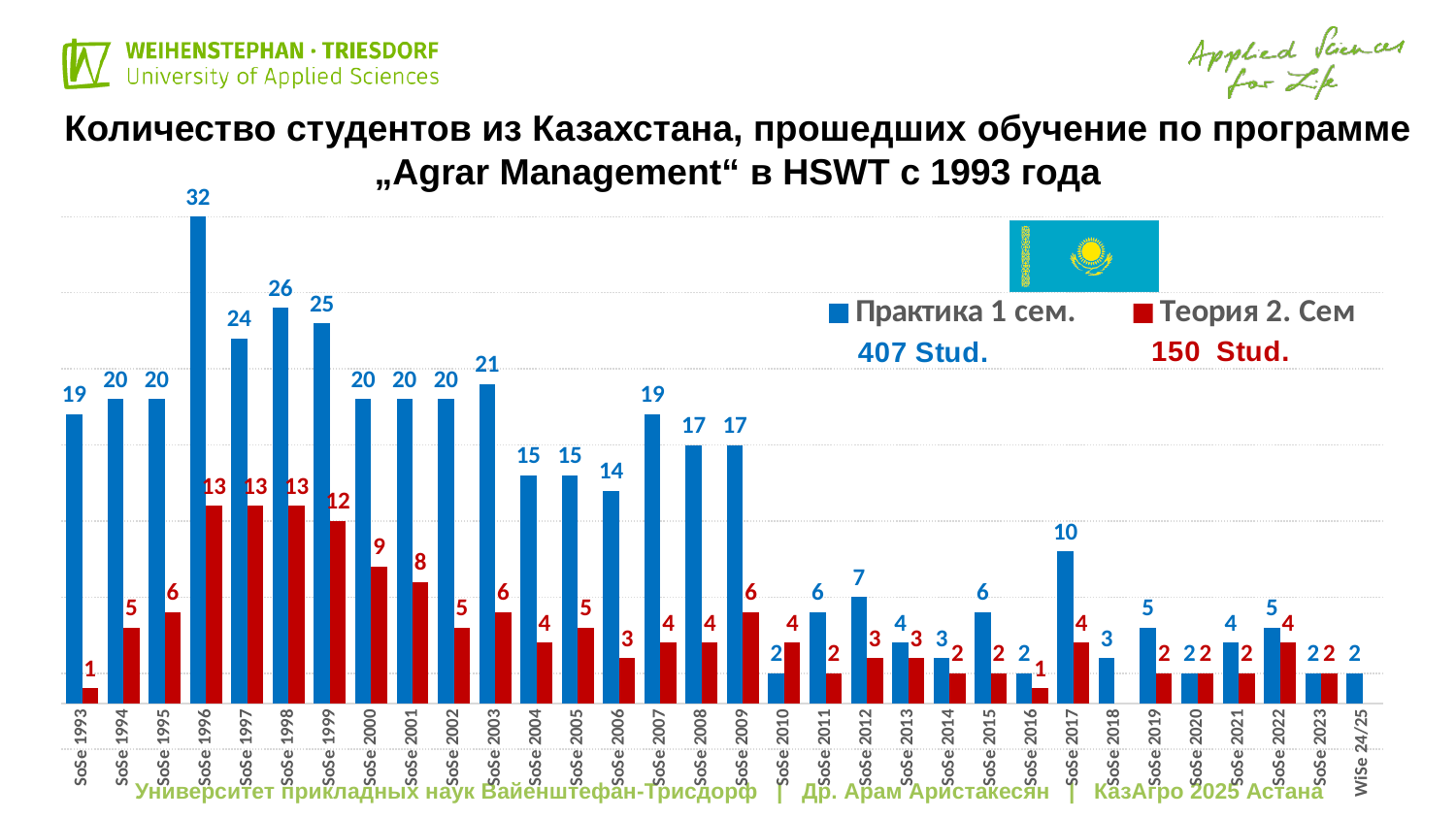
Which year has the highest value for Практика 1 сем.? SoSe 1996 What total number of students is shown next to the legend entry Теория 2. Сем? 150 Stud. What is the value of Теория 2. Сем for SoSe 2000? 9 Which is larger for SoSe 2003: Практика 1 сем. or Теория 2. Сем? Практика 1 сем. What type of chart is shown on the slide? bar chart How many series does the legend list? 2 What is the difference between Практика 1 сем. and Теория 2. Сем for SoSe 1998? 13 What is the value of Практика 1 сем. for WiSe 24/25? 2 What is the value of Практика 1 сем. for SoSe 1996? 32 What is the value of Теория 2. Сем for SoSe 1999? 12 What total number of students is shown next to the legend entry Практика 1 сем.? 407 Stud. What is the value of Практика 1 сем. for SoSe 2017? 10